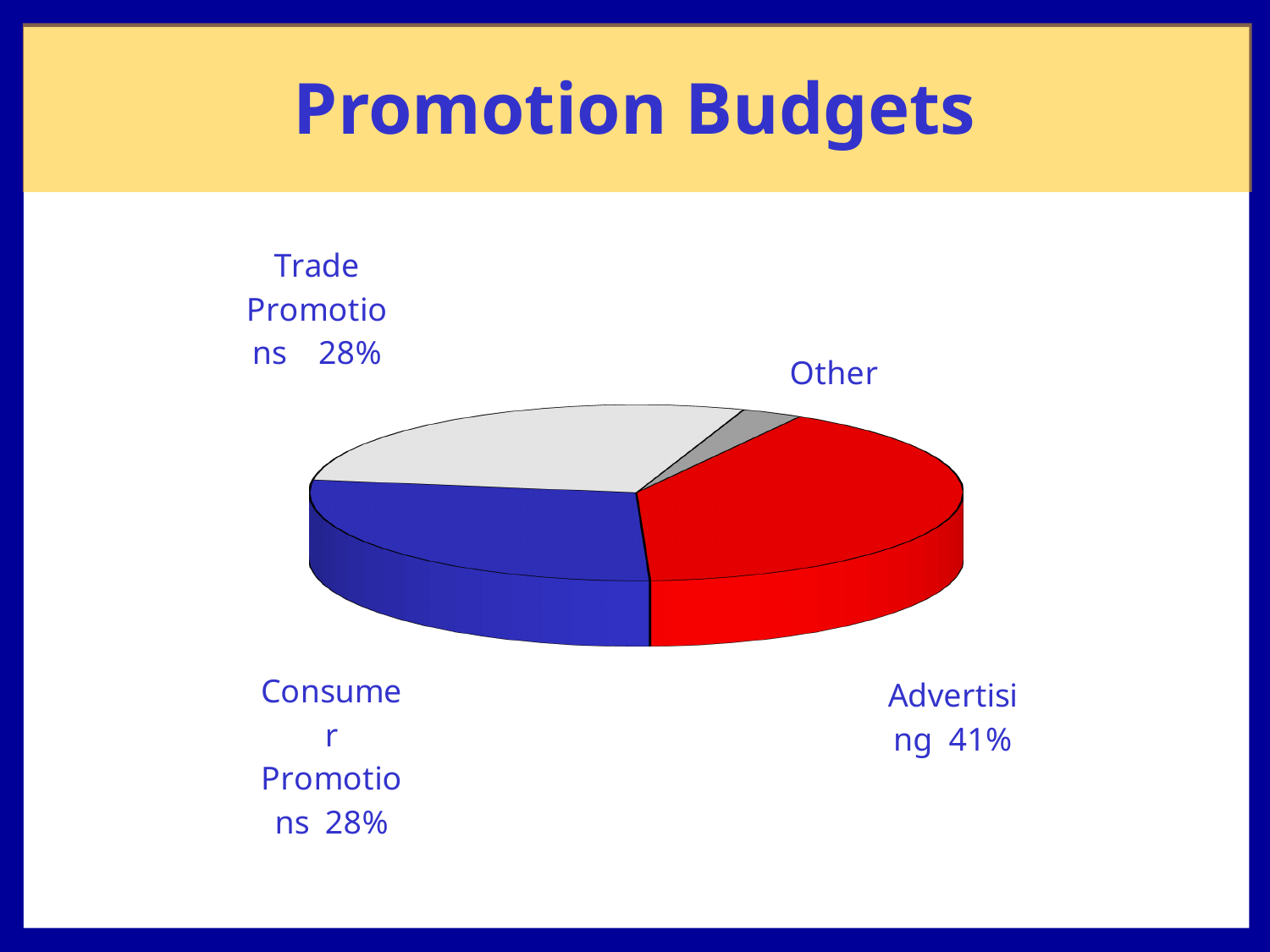
What is the title of the chart? Promotion Budgets Which is larger, the share for Advertising or the share for Consumer Promotions? Advertising Which category has the largest share of the promotion budget? Advertising Which category has the smallest slice of the pie? Other What colour is the Advertising slice? red What percentage of the promotion budget goes to Advertising? 41% By how many percentage points does Advertising exceed Trade Promotions? 13 How many slices does the pie chart have? 4 What percentage of the promotion budget goes to Consumer Promotions? 28% What kind of chart is shown on the slide? pie chart What percentage of the promotion budget goes to Trade Promotions? 28% Is the share for Advertising greater or less than 50%? less